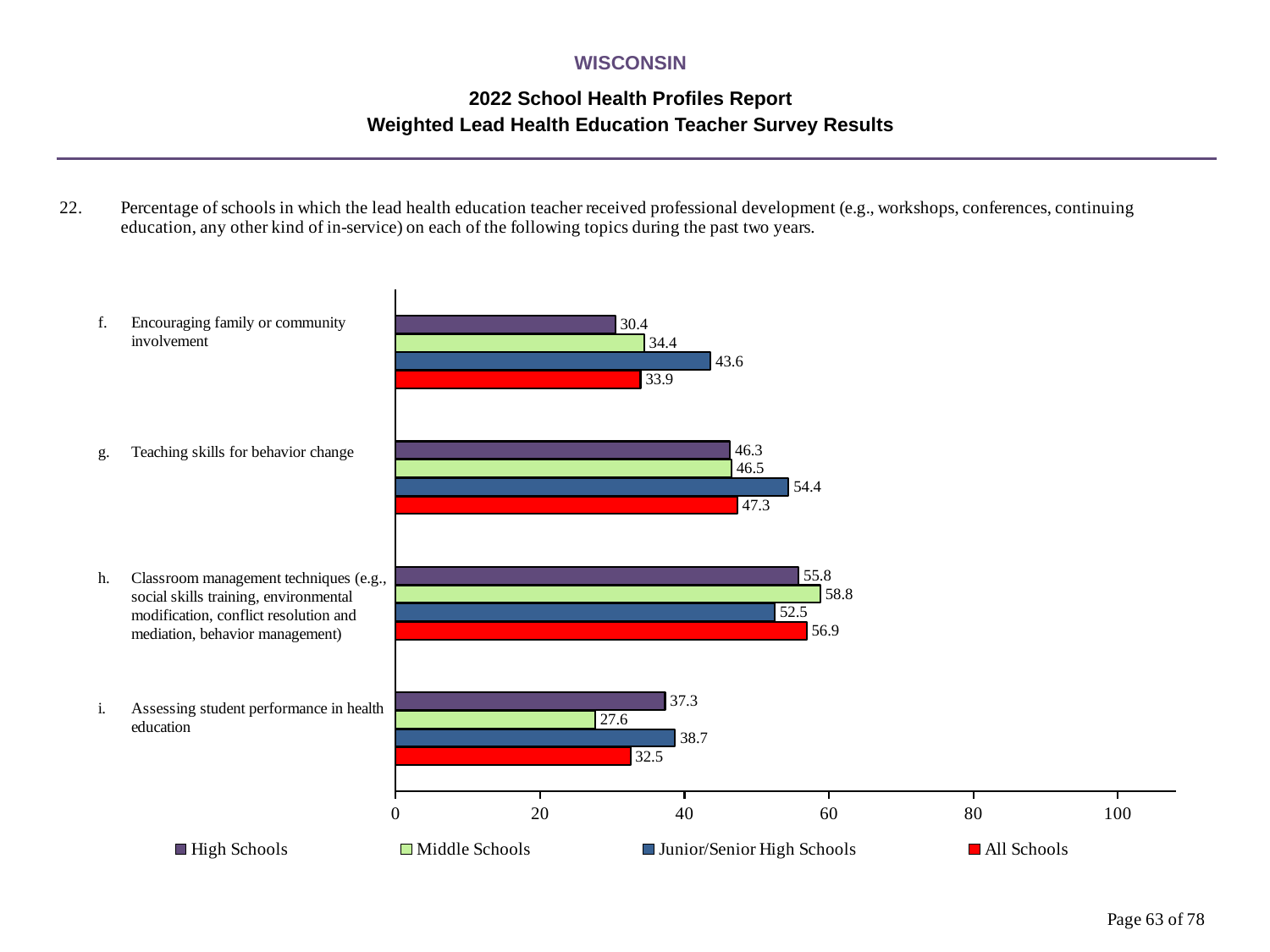
How many series does the legend list? 4 How many topics (categories) are shown on the chart? 4 What is the value for Junior/Senior High Schools for 'Encouraging family or community involvement'? 43.6 What is the value for Middle Schools for 'Classroom management techniques'? 58.8 What is the difference between the Junior/Senior High Schools and High Schools values for 'Encouraging family or community involvement'? 13.2 Which school type has the lowest value for 'Assessing student performance in health education'? Middle Schools Which is larger for 'Teaching skills for behavior change': the Junior/Senior High Schools value or the All Schools value? Junior/Senior High Schools Is the All Schools value for 'Classroom management techniques' greater or less than 40? greater Which school type has the highest value for 'Classroom management techniques'? Middle Schools What kind of chart is shown on the slide? Bar chart What is the value for High Schools for 'Assessing student performance in health education'? 37.3 What is the value for All Schools for 'Teaching skills for behavior change'? 47.3